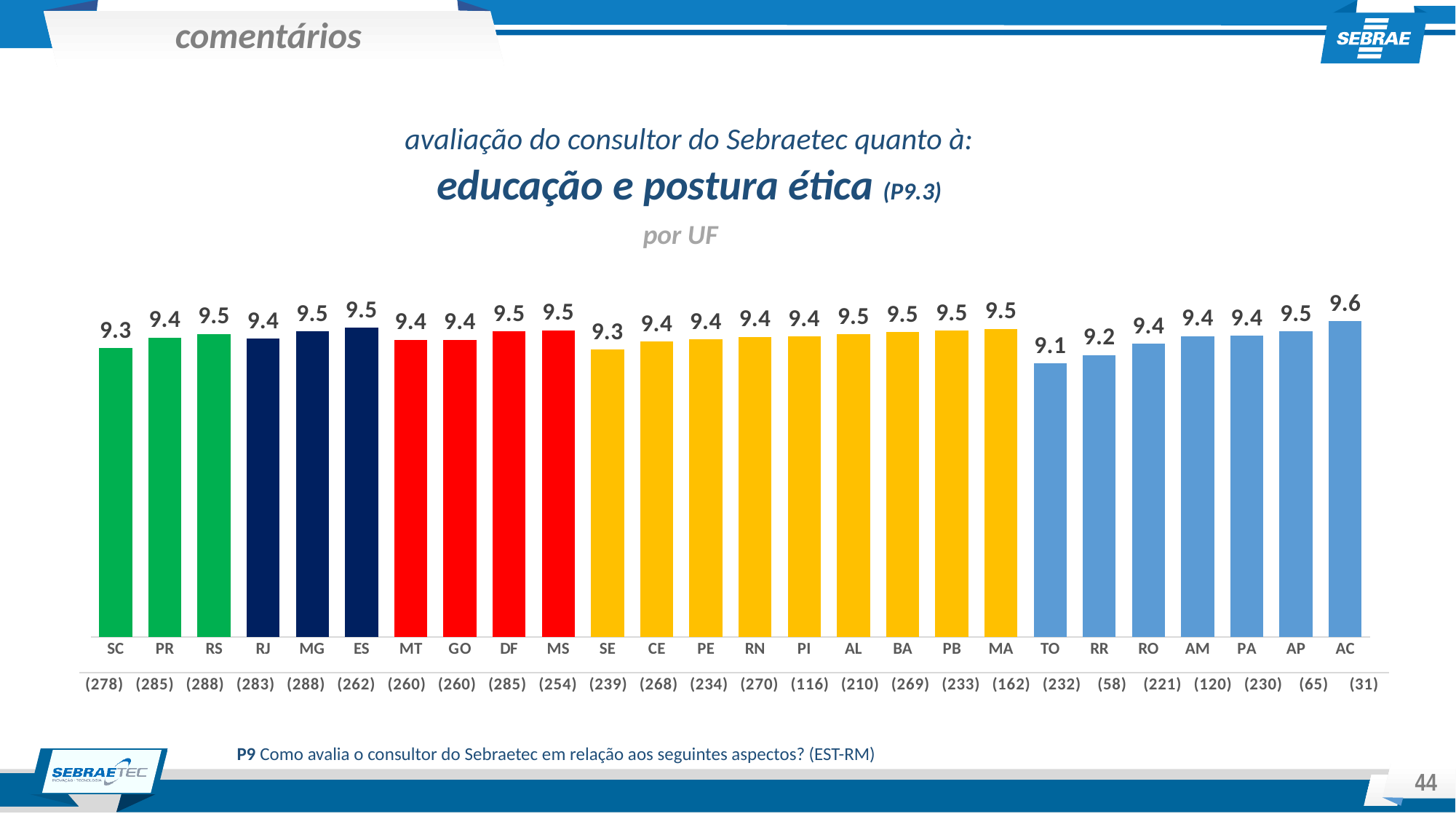
What is the value for RR? 9.2 What is the value for AC? 9.6 Which is larger, the value for MG or the value for RR? MG Which UF has the highest value? AC What kind of chart is shown on the slide? Bar chart What is the sample size shown in parentheses below the AC bar? (31) Which UF has the lowest value? TO What is the difference between the values for RS and SC? 0.2 How many UFs (bars) are shown in the chart? 26 What is the value for TO? 9.1 What is the value for SC? 9.3 What is the difference between the values for AC and TO? 0.5